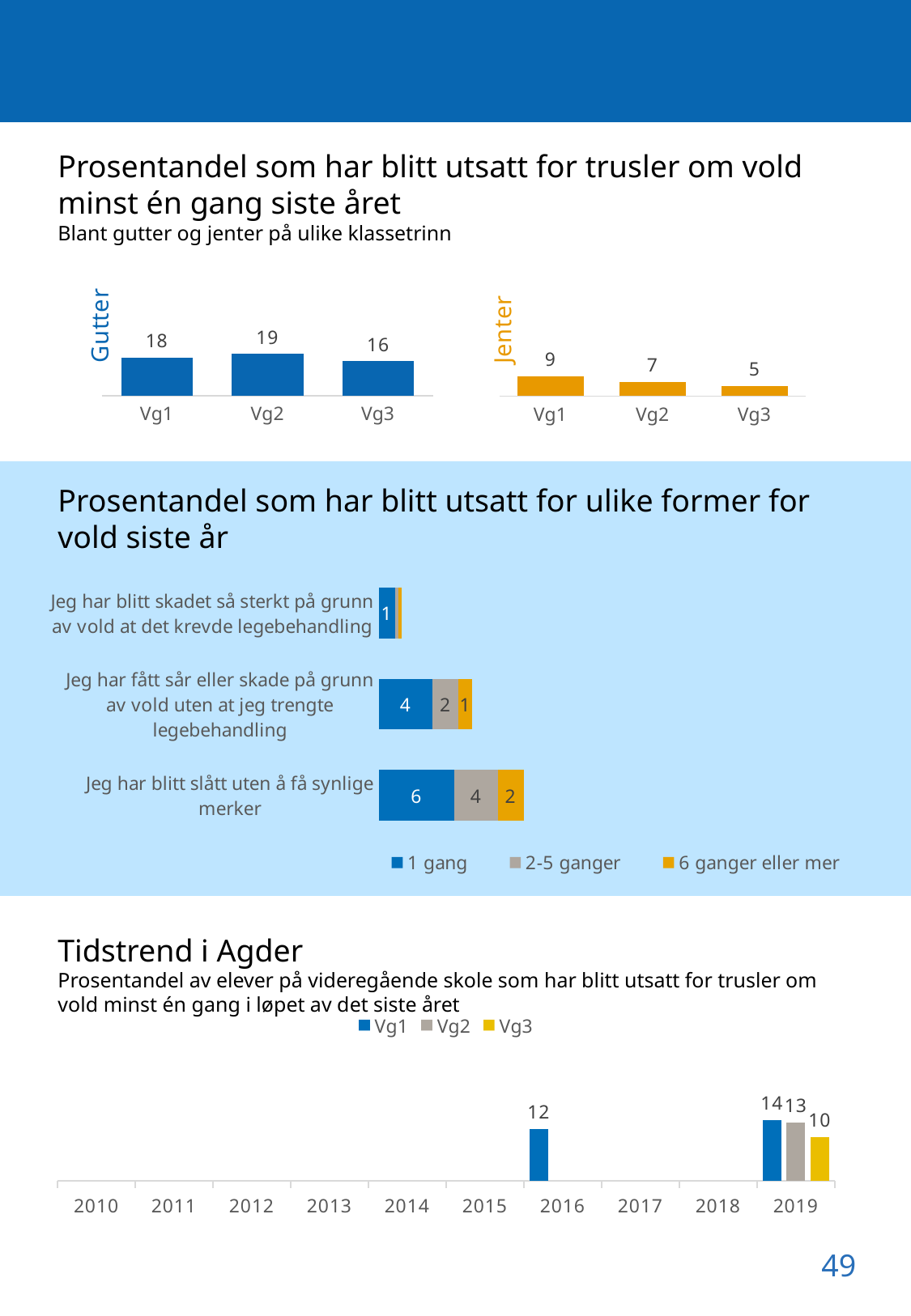
In the 'Tidstrend i Agder' chart, which series has the lowest value in 2019? Vg3 In the Jenter chart, do the values rise or fall from Vg1 to Vg3? fall In the stacked bar chart 'Prosentandel som har blitt utsatt for ulike former for vold siste år', what is the total of the bar for 'Jeg har blitt slått uten å få synlige merker'? 12 In the Jenter chart, what is the value for Vg3? 5 What kind of chart is the 'Tidstrend i Agder' chart? bar chart In the stacked bar chart 'Prosentandel som har blitt utsatt for ulike former for vold siste år', what is the '2-5 ganger' value for 'Jeg har fått sår eller skade på grunn av vold uten at jeg trengte legebehandling'? 2 In the 'Tidstrend i Agder' chart, what is the Vg2 value for 2019? 13 In the Jenter chart, which category has the highest value? Vg1 In the Gutter chart, what is the value for Vg2? 19 In the Gutter chart, which category has the lowest value? Vg3 How many series does the legend of the stacked bar chart 'Prosentandel som har blitt utsatt for ulike former for vold siste år' list? 3 What is the difference between the Gutter value for Vg1 and the Jenter value for Vg1? 9